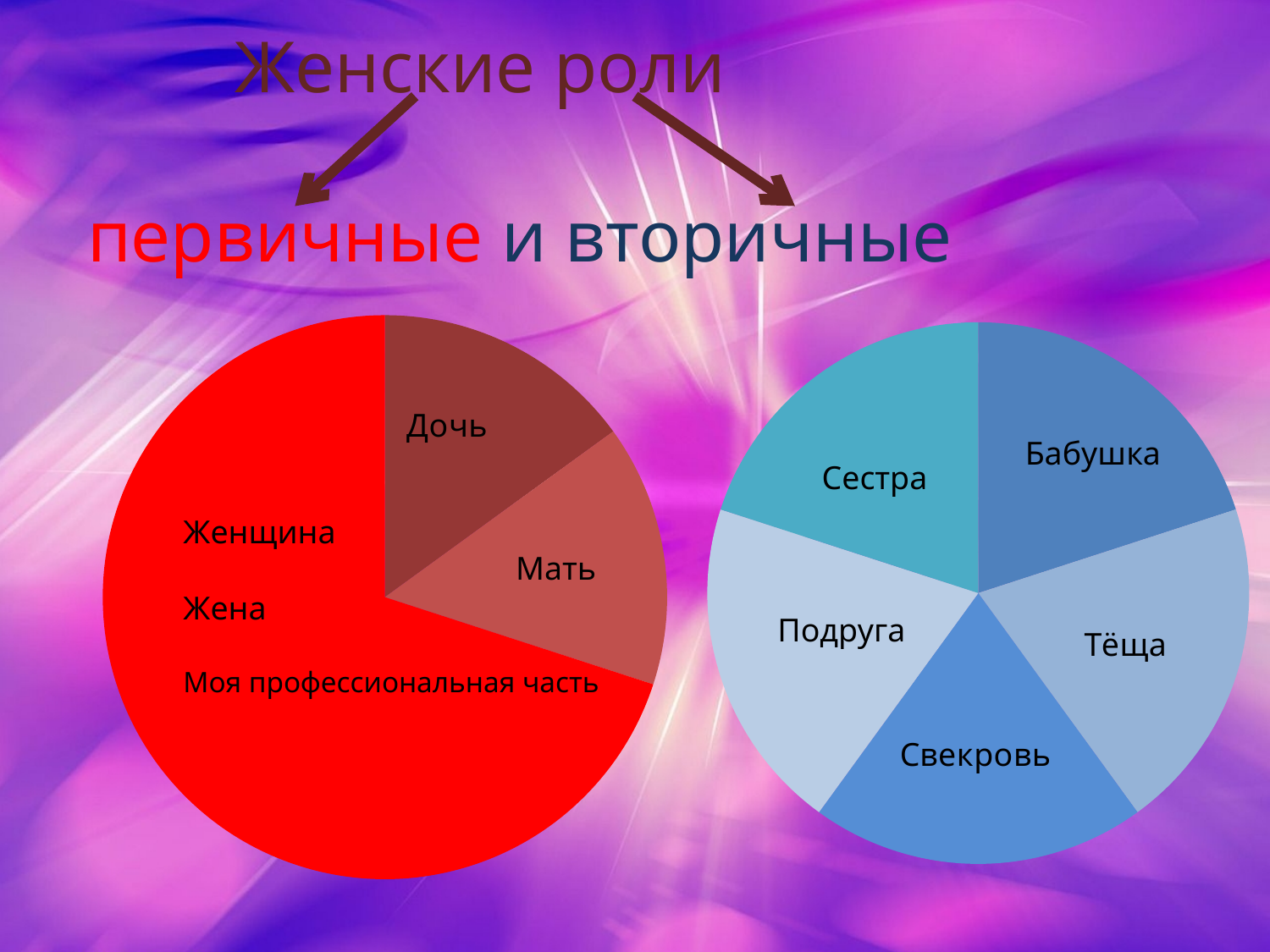
Which slices are shown in the right (blue) pie chart? Бабушка, Тёща, Свекровь, Подруга, Сестра In the left (red) pie chart, which slice is the largest? Женщина / Жена / Моя профессиональная часть What is the title at the top of the slide? Женские роли What kind of chart is the right chart (the blue one) on the slide? pie chart In the left (red) pie chart, which is larger: the slice labelled Дочь or the slice labelled Женщина / Жена / Моя профессиональная часть? Женщина / Жена / Моя профессиональная часть Which pie chart corresponds to the 'первичные' roles, the left one or the right one? the left one How many slices does the left (red) pie chart have? 3 How many slices does the right (blue) pie chart have? 5 What kind of chart is the left chart (the red one) on the slide? pie chart In the left (red) pie chart, which is larger: the slice labelled Мать or the slice labelled Женщина / Жена / Моя профессиональная часть? Женщина / Жена / Моя профессиональная часть